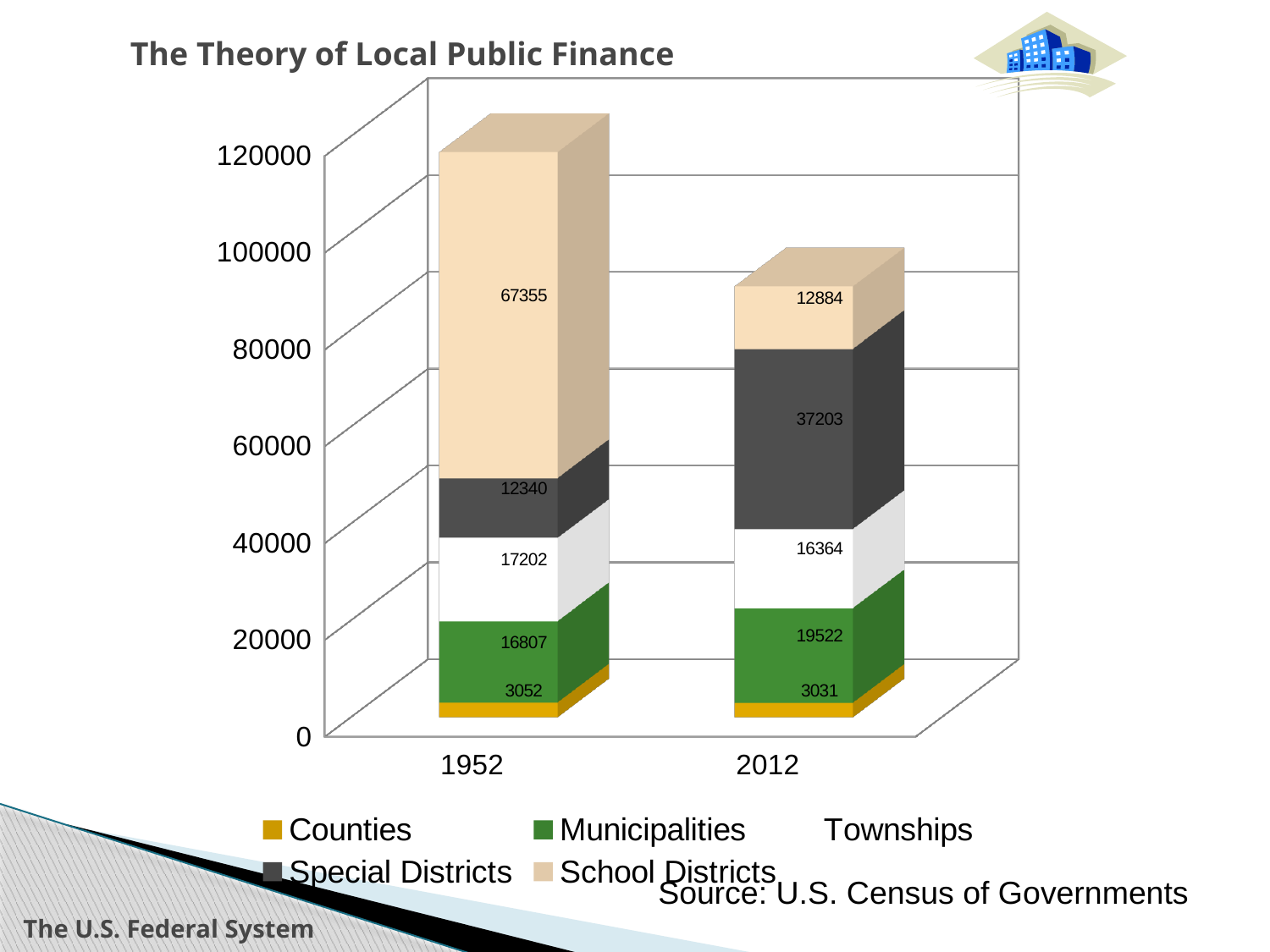
How many categories (years) are shown on the x axis? 2 Which series has the smallest value in the 2012 bar? Counties What is the total of the stacked bar for 2012? 89004 What is the difference between the School Districts value in 1952 and in 2012? 54471 What is the value for School Districts in 1952? 67355 Which is larger, Municipalities in 1952 or Municipalities in 2012? Municipalities in 2012 Which series has the largest value in the 1952 bar? School Districts What is the value for Counties in 2012? 3031 What is the value for Townships in 1952? 17202 What is the value for Special Districts in 2012? 37203 What kind of chart is shown on the slide? stacked bar chart How many series does the legend list? 5